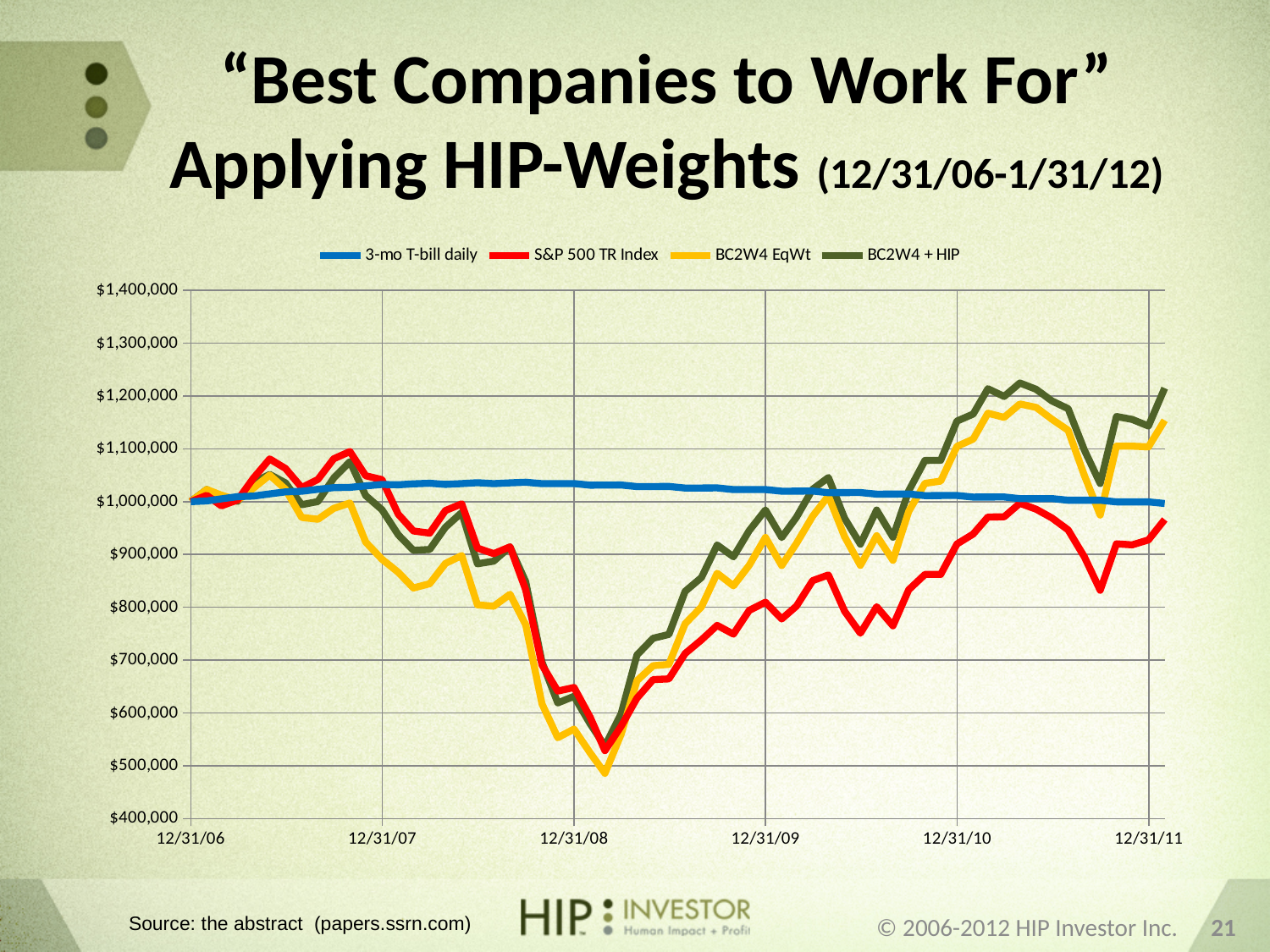
What value do all four series start at on 12/31/06? $1,000,000 Is the value of the S&P 500 TR Index at 12/31/08 greater or less than $800,000? less Does the S&P 500 TR Index rise or fall between 12/31/07 and 12/31/08? fall What kind of chart is shown on the slide? line chart Is the lowest point reached by BC2W4 EqWt greater or less than $600,000? less Which series ends highest at the right edge of the chart? BC2W4 + HIP Which series is drawn in red? S&P 500 TR Index Which series reaches the lowest point anywhere on the chart? BC2W4 EqWt At the right end of the chart, which is higher: BC2W4 + HIP or the S&P 500 TR Index? BC2W4 + HIP How many series does the legend list? 4 Is the value of BC2W4 + HIP at 12/31/11 greater or less than $1,000,000? greater How many date labels are shown on the x axis? 6